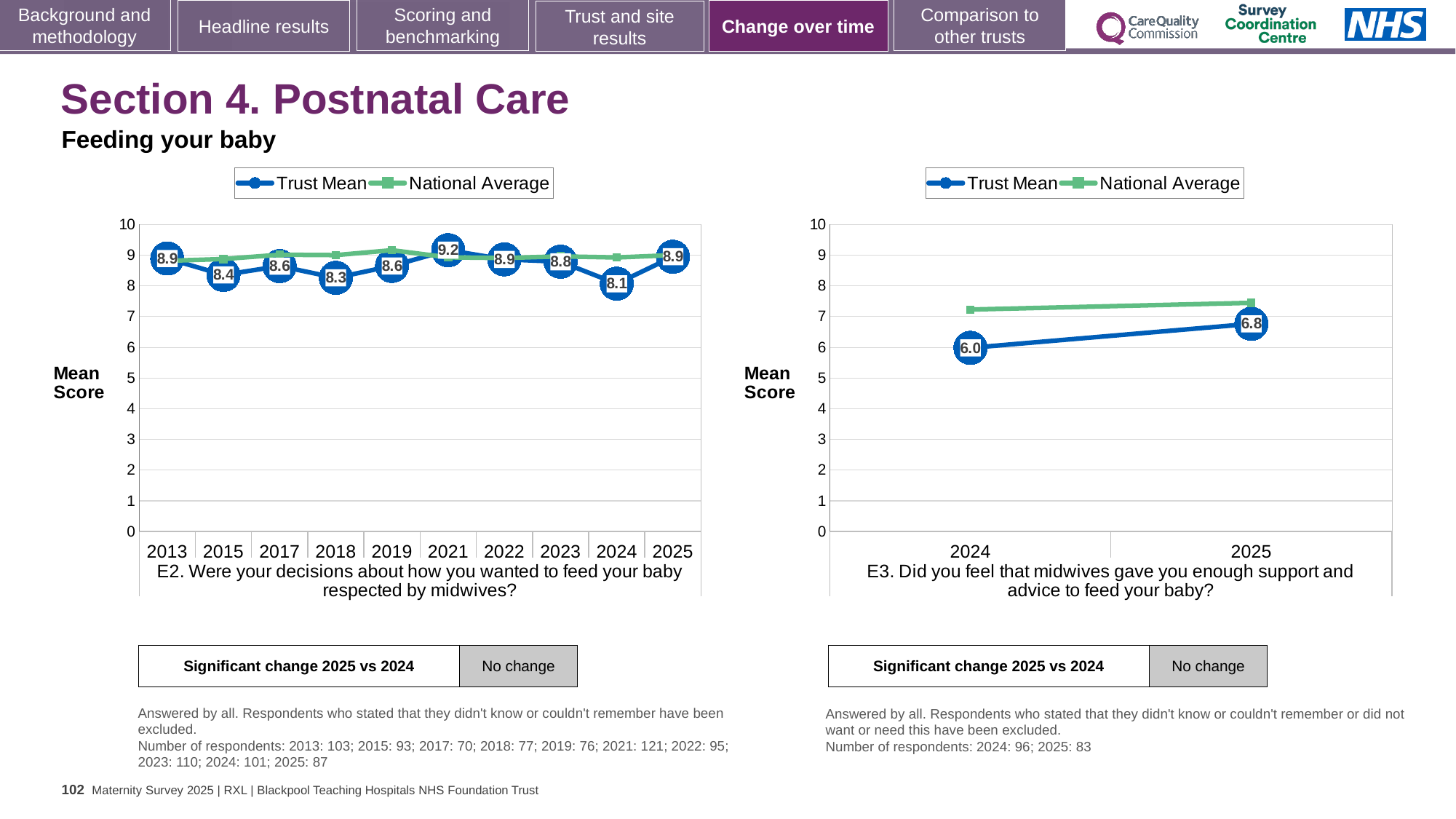
What kind of chart is the E2 chart on the left? Line chart In the E2 chart on the left, what is the Trust Mean score for 2024? 8.1 In the E3 chart on the right, what is the difference between the Trust Mean scores for 2025 and 2024? 0.8 In the E2 chart on the left, which is larger: the Trust Mean score for 2018 or for 2019? 2019 In the E3 chart on the right, what is the Trust Mean score for 2024? 6.0 In the E2 chart on the left, which year has the lowest Trust Mean score? 2024 In the E3 chart on the right, is the National Average for 2024 greater or less than 7? greater In the E2 chart on the left, what is the Trust Mean score for 2021? 9.2 In the E3 chart on the right, does the Trust Mean rise or fall from 2024 to 2025? Rise In the E2 chart on the left, which year has the highest Trust Mean score? 2021 How many years are shown on the x axis of the E2 chart on the left? 10 How many series does the legend of the E3 chart on the right list? 2